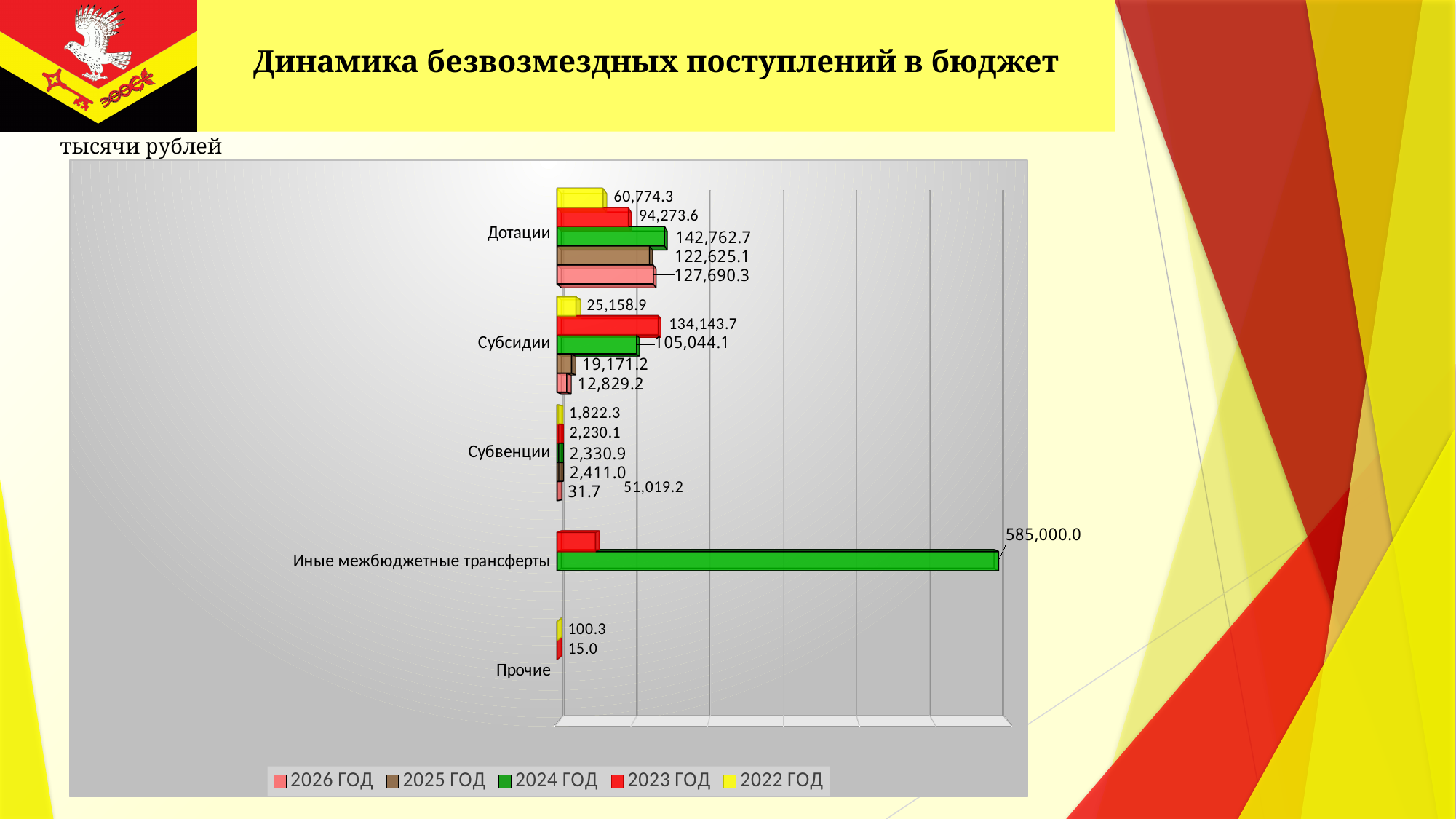
How many series does the legend list? 5 What is the value for Субсидии in 2023 ГОД? 134,143.7 Which year has the highest value for Дотации? 2024 ГОД How many categories are shown on the chart? 5 What is the value for Прочие in 2022 ГОД? 100.3 Which is larger for Субсидии: the 2023 ГОД value or the 2024 ГОД value? 2023 ГОД Which year has the lowest value for Субвенции? 2026 ГОД What is the difference between the 2024 ГОД and 2023 ГОД values for Дотации? 48,489.1 What is the value for Иные межбюджетные трансферты in 2024 ГОД? 585,000.0 What kind of chart is shown on the slide? Bar chart In what units are the chart values given? тысячи рублей What is the value for Дотации in 2024 ГОД? 142,762.7